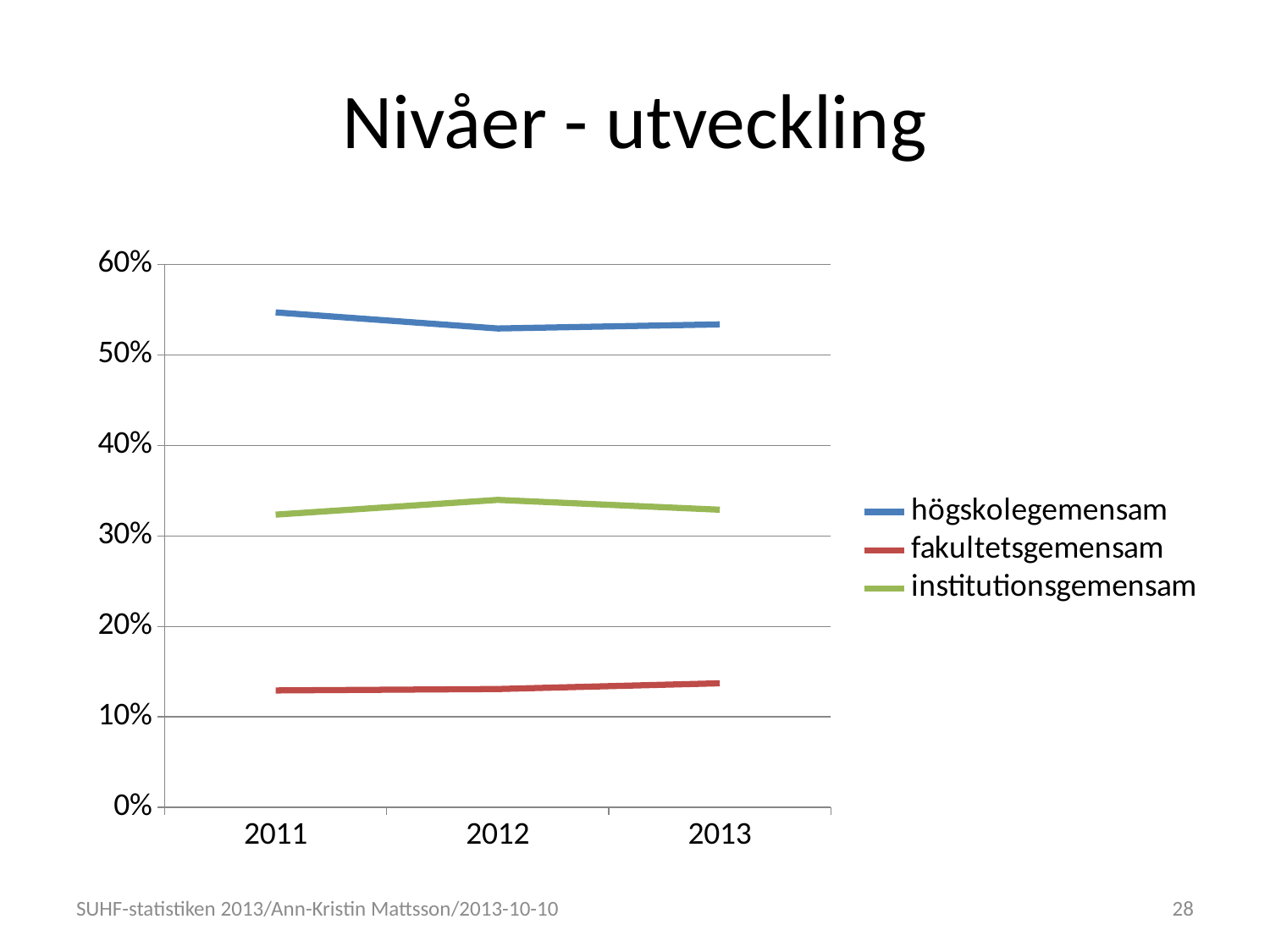
What is the title of the chart? Nivåer - utveckling Is the value for högskolegemensam in 2011 greater or less than 50%? greater Which is larger in 2013, institutionsgemensam or fakultetsgemensam? institutionsgemensam What kind of chart is shown on the slide? line chart Which series has the lowest values across all years? fakultetsgemensam Does the fakultetsgemensam line rise or fall from 2011 to 2013? rise How many years are shown on the x axis? 3 Which colour is used for the institutionsgemensam series? green Which series has the highest values across all years? högskolegemensam Is the value for fakultetsgemensam in 2013 greater or less than 20%? less Is the value for institutionsgemensam in 2012 greater or less than 30%? greater How many series does the legend list? 3